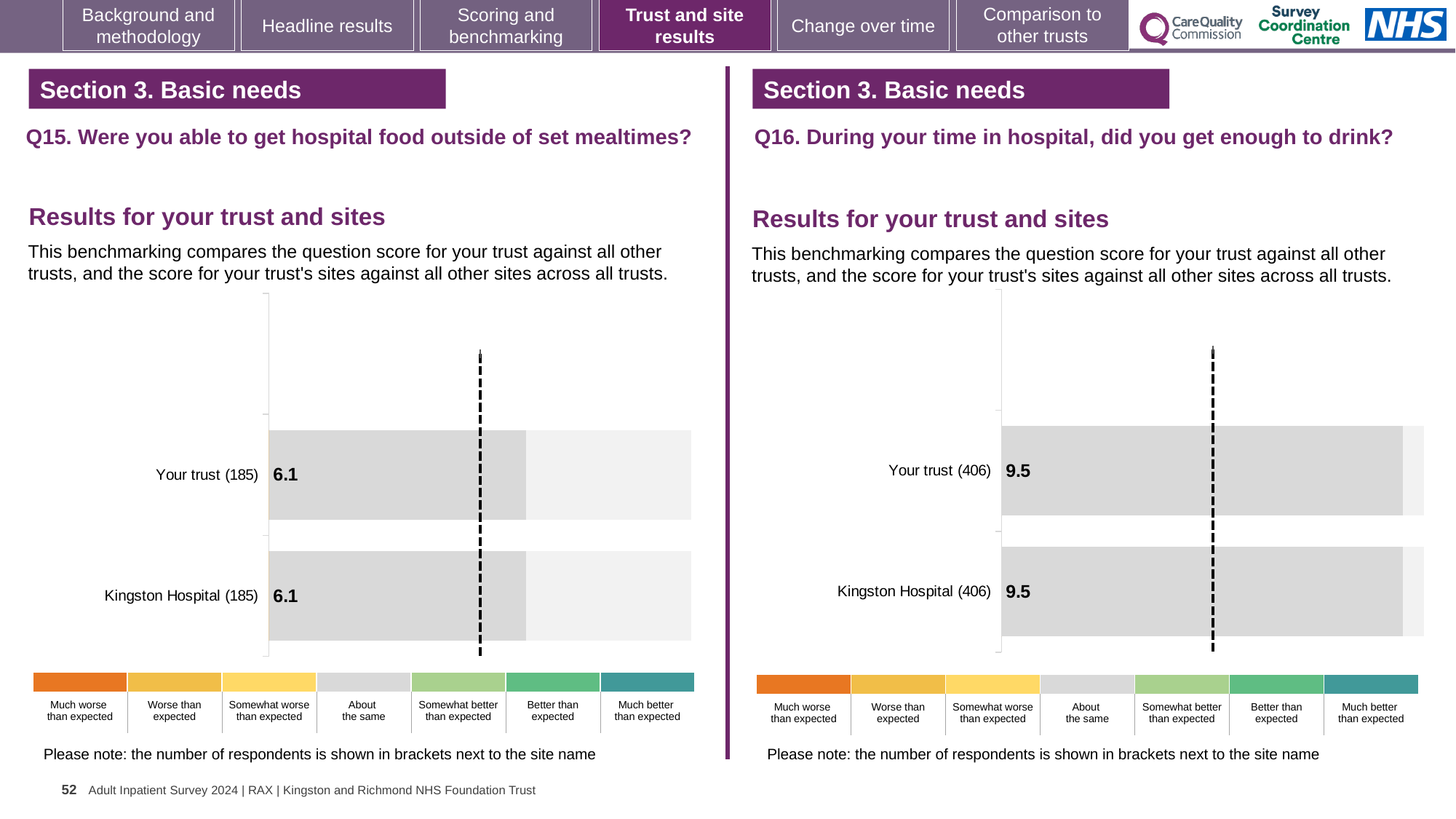
How many bars are plotted on the Q15 chart (left)? 2 On the Q15 chart (left), what is the difference between the Your trust score and the Kingston Hospital score? 0 What kind of chart is used for the Q15 results on the left? Bar chart On the Q16 chart (right), what is the score for Your trust? 9.5 On the Q15 chart (left), what is the score for Your trust? 6.1 Is the Your trust score on the Q16 chart (right) larger or smaller than the Your trust score on the Q15 chart (left)? Larger On the Q16 chart (right), what is the difference between the Your trust score and the Kingston Hospital score? 0 On the Q15 chart (left), how many respondents are shown in brackets for Kingston Hospital? 185 How many bars are plotted on the Q16 chart (right)? 2 On the Q15 chart (left), what is the score for Kingston Hospital? 6.1 On the Q16 chart (right), what is the score for Kingston Hospital? 9.5 On the Q16 chart (right), how many respondents are shown in brackets for Your trust? 406